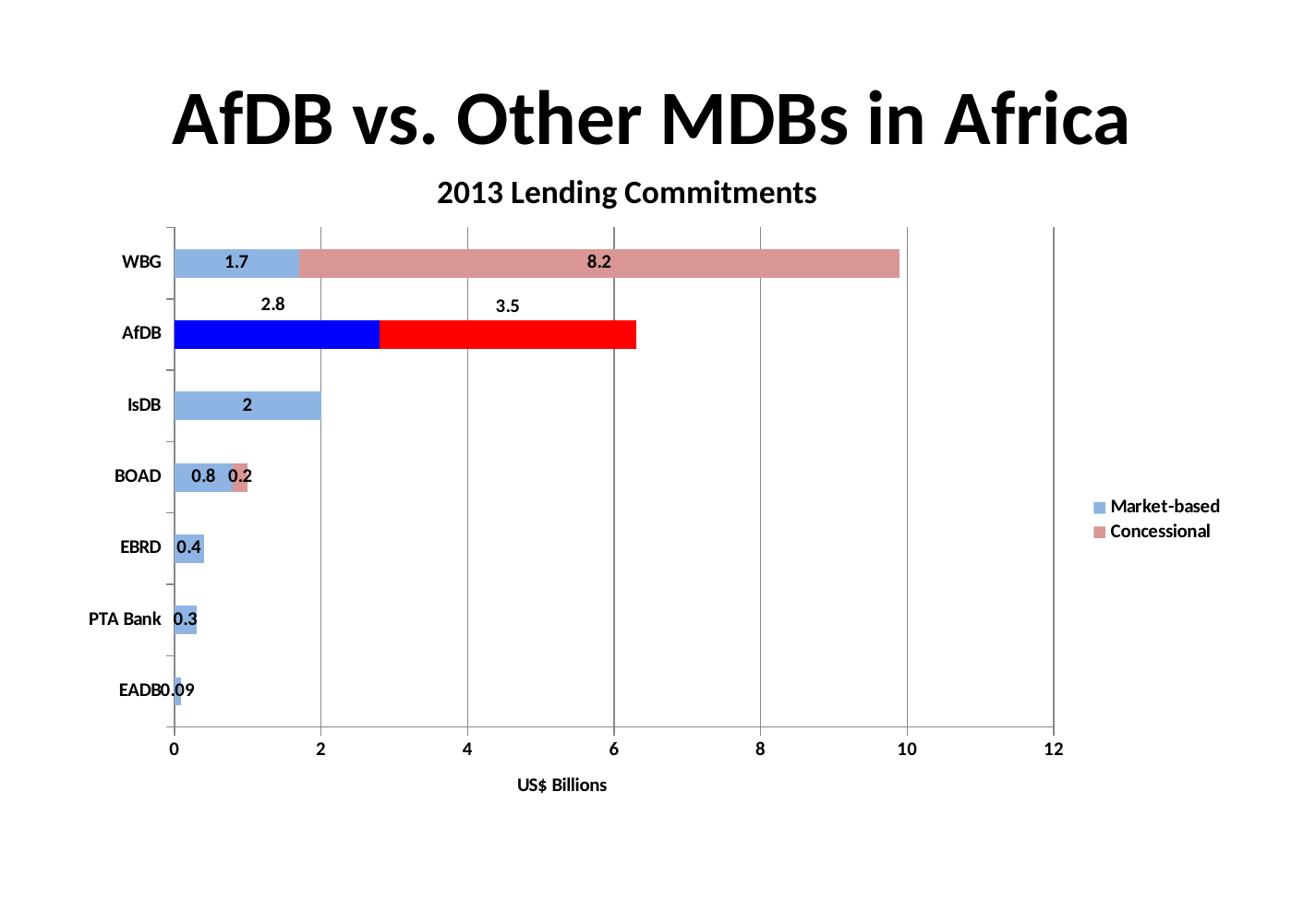
How many institutions are shown on the chart? 7 What is the Market-based lending commitment for WBG? 1.7 What is the Concessional lending commitment for AfDB? 3.5 What is the Market-based value for IsDB? 2 Which institution has the largest Concessional lending commitment? WBG Which has a larger Market-based value, AfDB or WBG? AfDB Which institution has the smallest Market-based lending commitment? EADB What is the total lending commitment for AfDB (Market-based plus Concessional)? 6.3 How many series does the legend list? 2 What is the difference between the Concessional values for WBG and AfDB? 4.7 What is the Concessional value for BOAD? 0.2 What type of chart is shown? Stacked bar chart